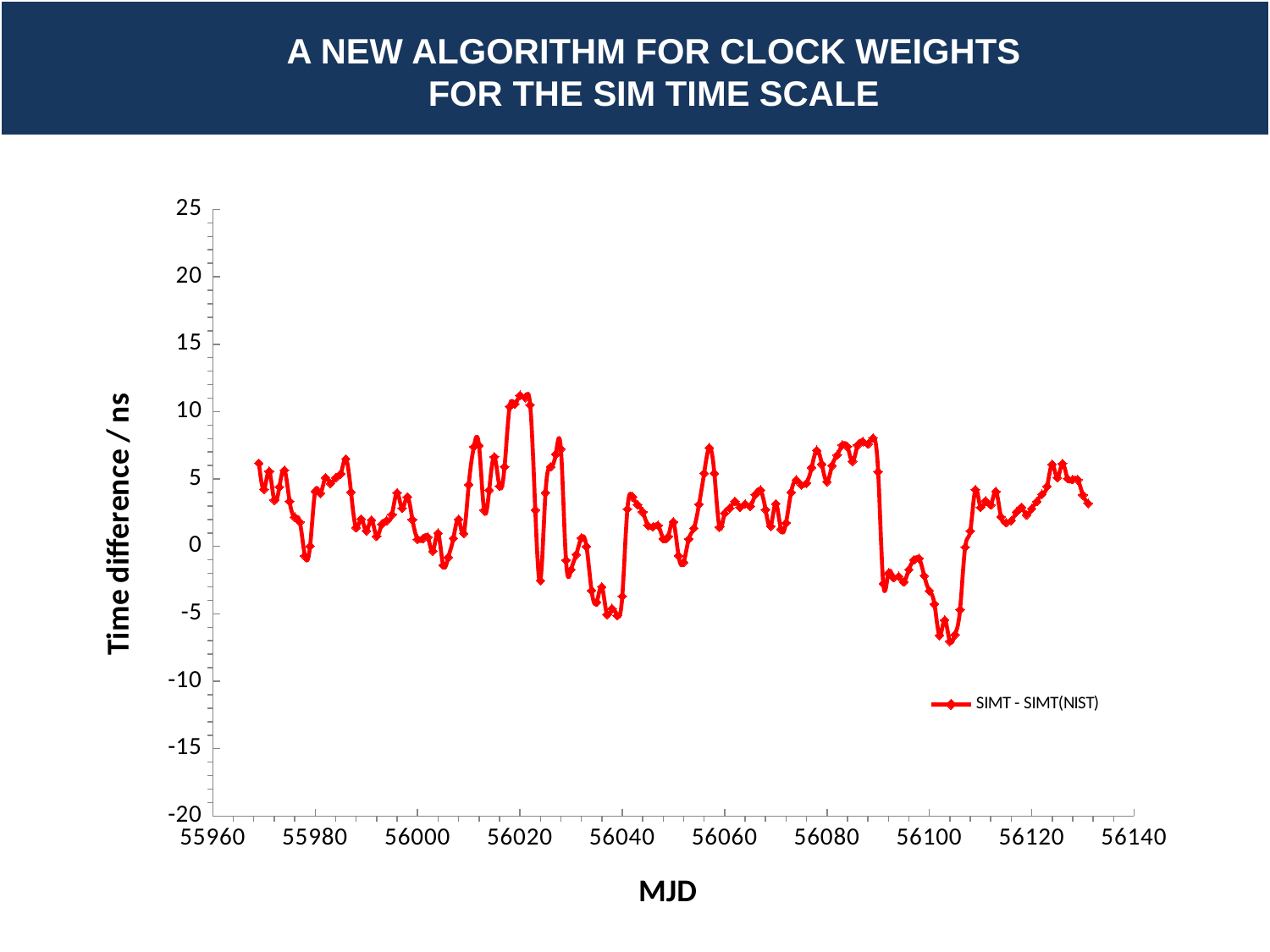
What is the name of the series shown in the legend? SIMT - SIMT(NIST) How many series does the legend list? 1 Is the value for MJD 56020 greater or less than 10? greater What is the label of the y axis? Time difference / ns Is the value for MJD 56088 greater or less than 5? greater What kind of chart is shown on the slide? line chart Is the value for MJD 56103 greater or less than -5? less Around which MJD does the series reach its lowest value? around MJD 56104 Around which MJD does the series reach its highest value? around MJD 56020 Which is larger, the value at MJD 56020 or the value at MJD 56103? MJD 56020